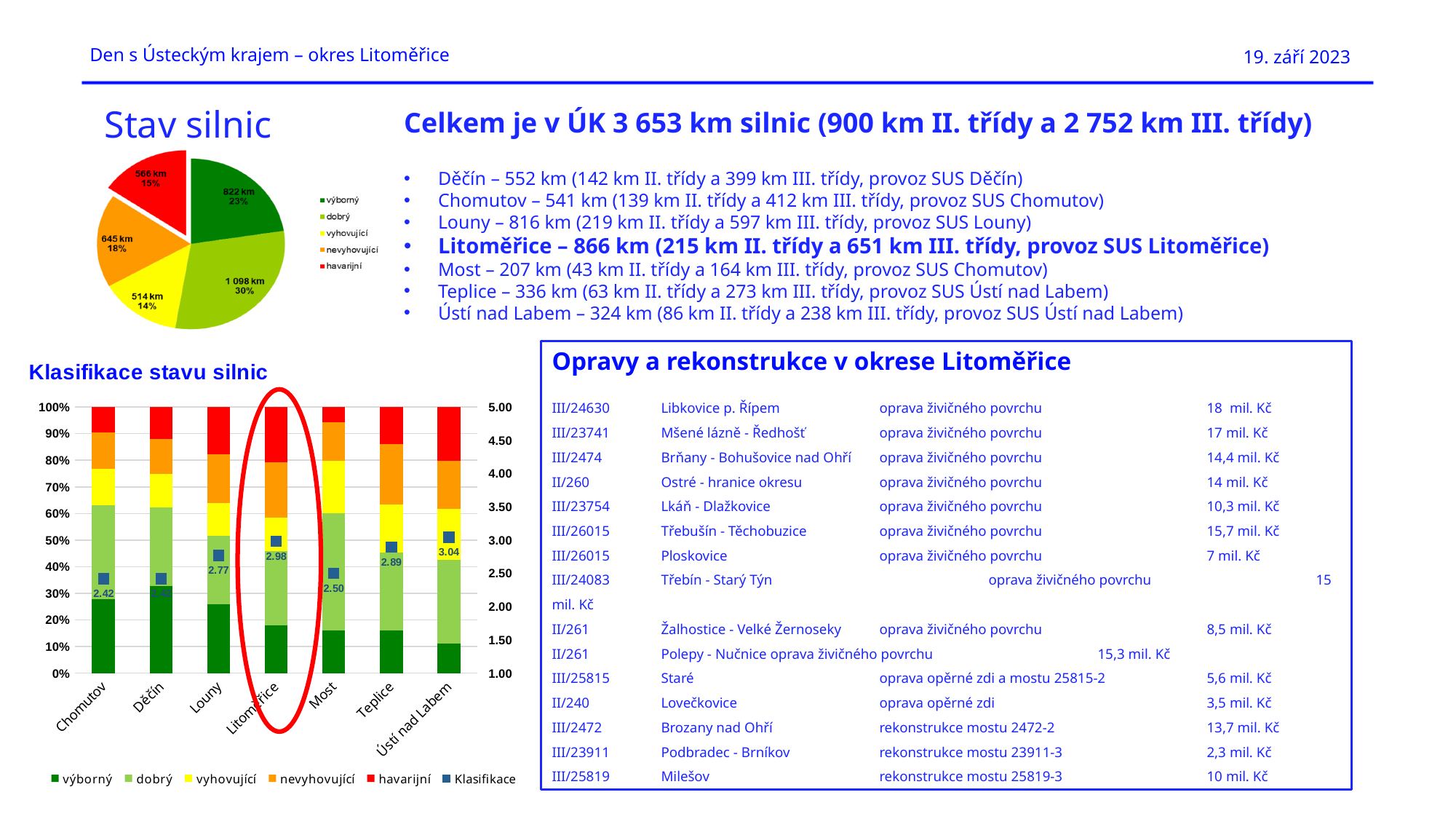
How many districts are shown on the x axis of the chart 'Klasifikace stavu silnic'? 7 In the pie chart 'Stav silnic', what is the difference in km between the 'výborný' and 'havarijní' slices? 256 km In the pie chart 'Stav silnic', what value is shown for the 'dobrý' slice? 1 098 km What kind of chart is 'Klasifikace stavu silnic'? Stacked bar chart In the pie chart 'Stav silnic', which category has the smallest slice? vyhovující In the chart 'Klasifikace stavu silnic', which district has the highest Klasifikace value? Ústí nad Labem How many entries does the legend of the chart 'Klasifikace stavu silnic' list? 6 In the pie chart 'Stav silnic', which category has the largest slice? dobrý In the pie chart 'Stav silnic', what percentage share does the 'havarijní' slice have? 15% How many categories does the legend of the pie chart 'Stav silnic' list? 5 In the chart 'Klasifikace stavu silnic', which has the higher Klasifikace value, Louny or Most? Louny In the chart 'Klasifikace stavu silnic', what is the Klasifikace value for Litoměřice? 2.98